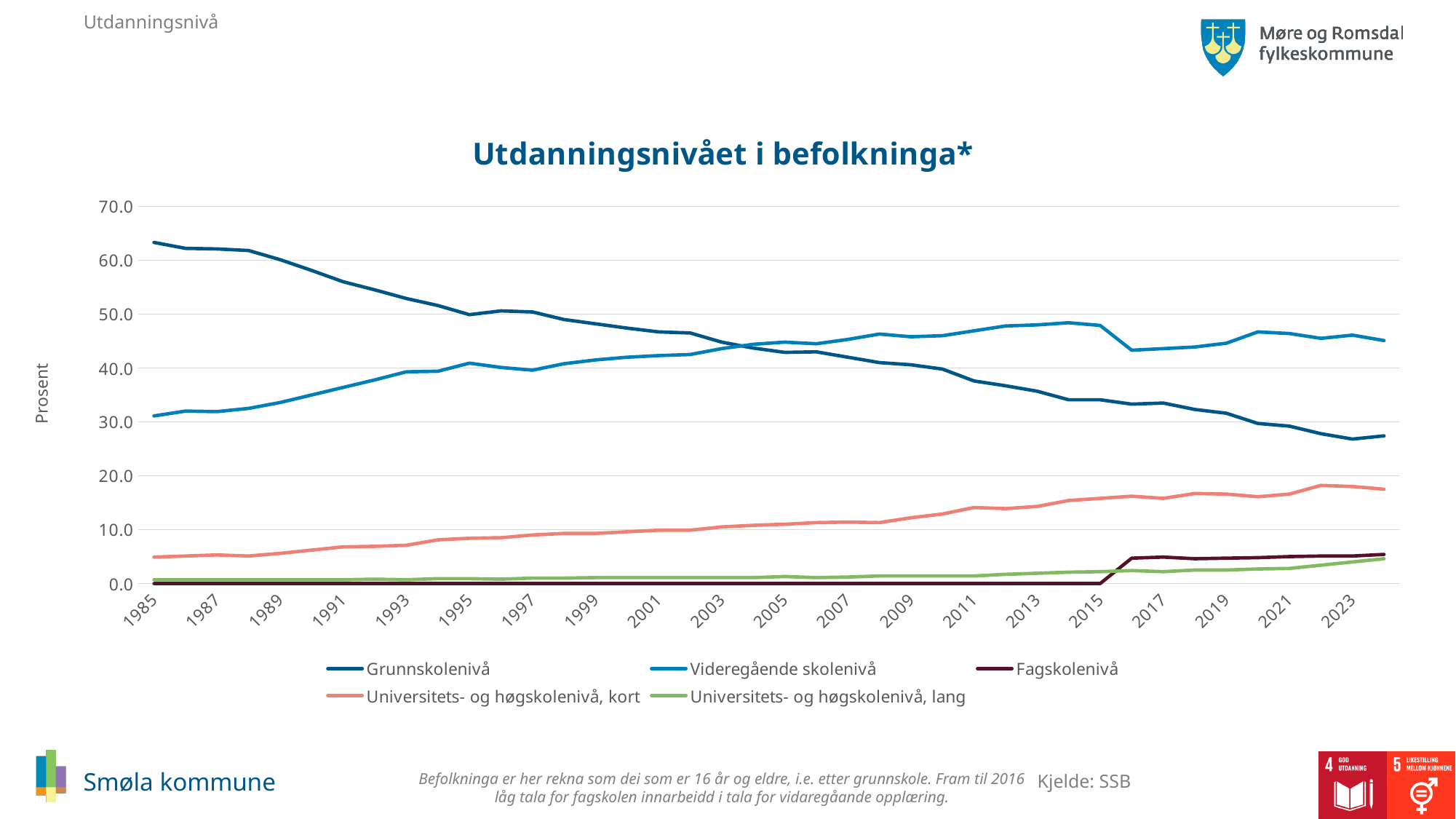
What kind of chart is shown on the slide? line chart Is the value for Universitets- og høgskolenivå, kort in 2023 greater or less than 10.0? greater Which series has the highest value in 1985? Grunnskolenivå Does the Grunnskolenivå line rise or fall from 1985 to 2023? fall Is the value for Grunnskolenivå in 2023 greater or less than 30.0? less What is the label on the vertical axis? Prosent What is the title of the chart? Utdanningsnivået i befolkninga* Does the Universitets- og høgskolenivå, kort line rise or fall from 1985 to 2023? rise In 2023, which is larger: Videregående skolenivå or Grunnskolenivå? Videregående skolenivå Is the value for Grunnskolenivå in 1985 greater or less than 60.0? greater How many series does the legend list? 5